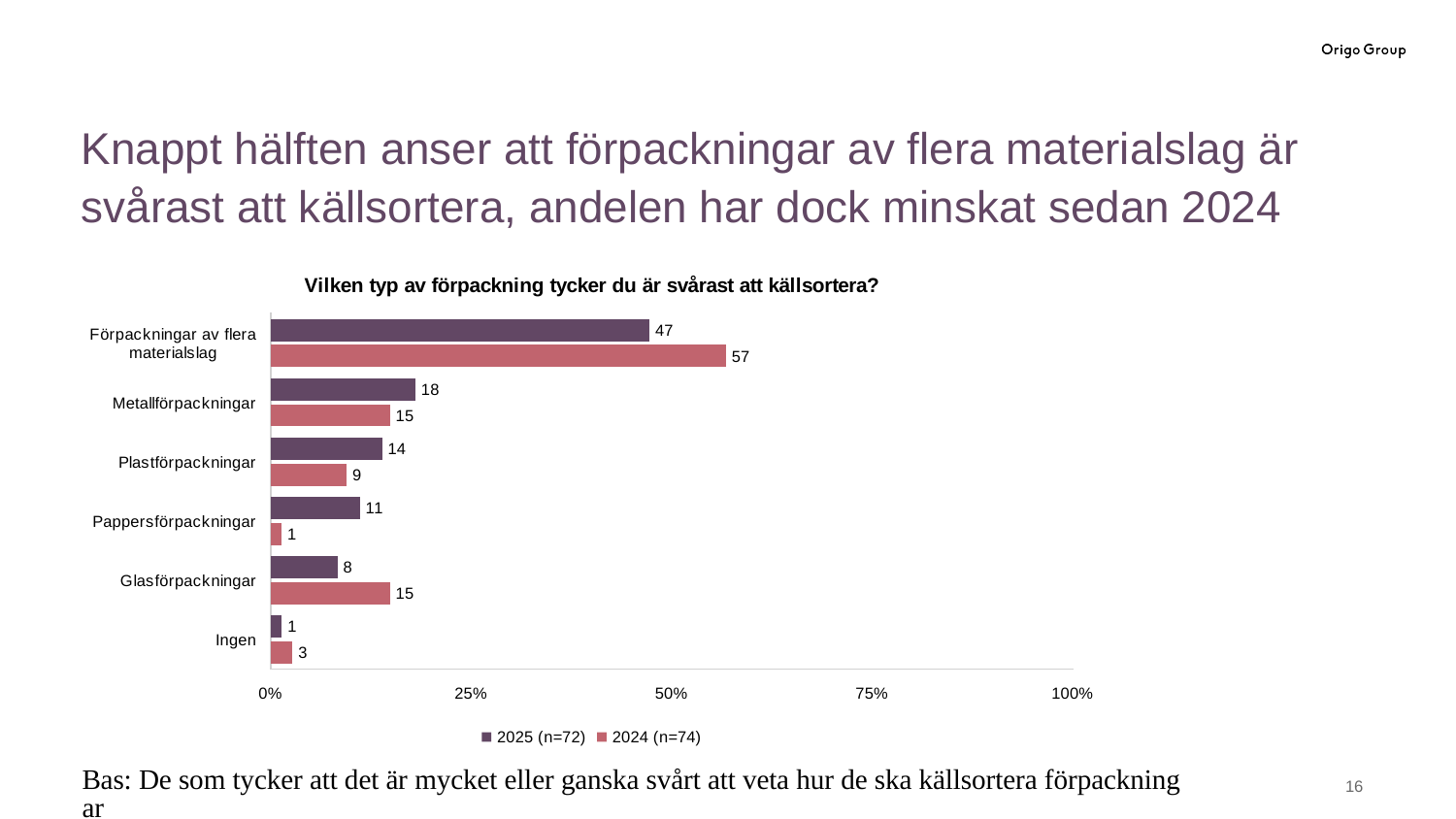
What is the title of the chart? Vilken typ av förpackning tycker du är svårast att källsortera? How many categories are shown on the chart? 6 How many series does the legend list? 2 What kind of chart is shown on the slide? Bar chart Which category has the highest value in the 2024 (n=74) series? Förpackningar av flera materialslag Which category has the lowest value in the 2025 (n=72) series? Ingen Is the 2024 (n=74) value for Förpackningar av flera materialslag greater or less than 50%? greater What is the difference between the 2024 (n=74) and 2025 (n=72) values for Förpackningar av flera materialslag? 10 What is the value for Pappersförpackningar in the 2024 (n=74) series? 1 What is the value for Förpackningar av flera materialslag in the 2025 (n=72) series? 47 Which is larger for Glasförpackningar: the 2025 (n=72) value or the 2024 (n=74) value? 2024 (n=74) What is the value for Glasförpackningar in the 2024 (n=74) series? 15